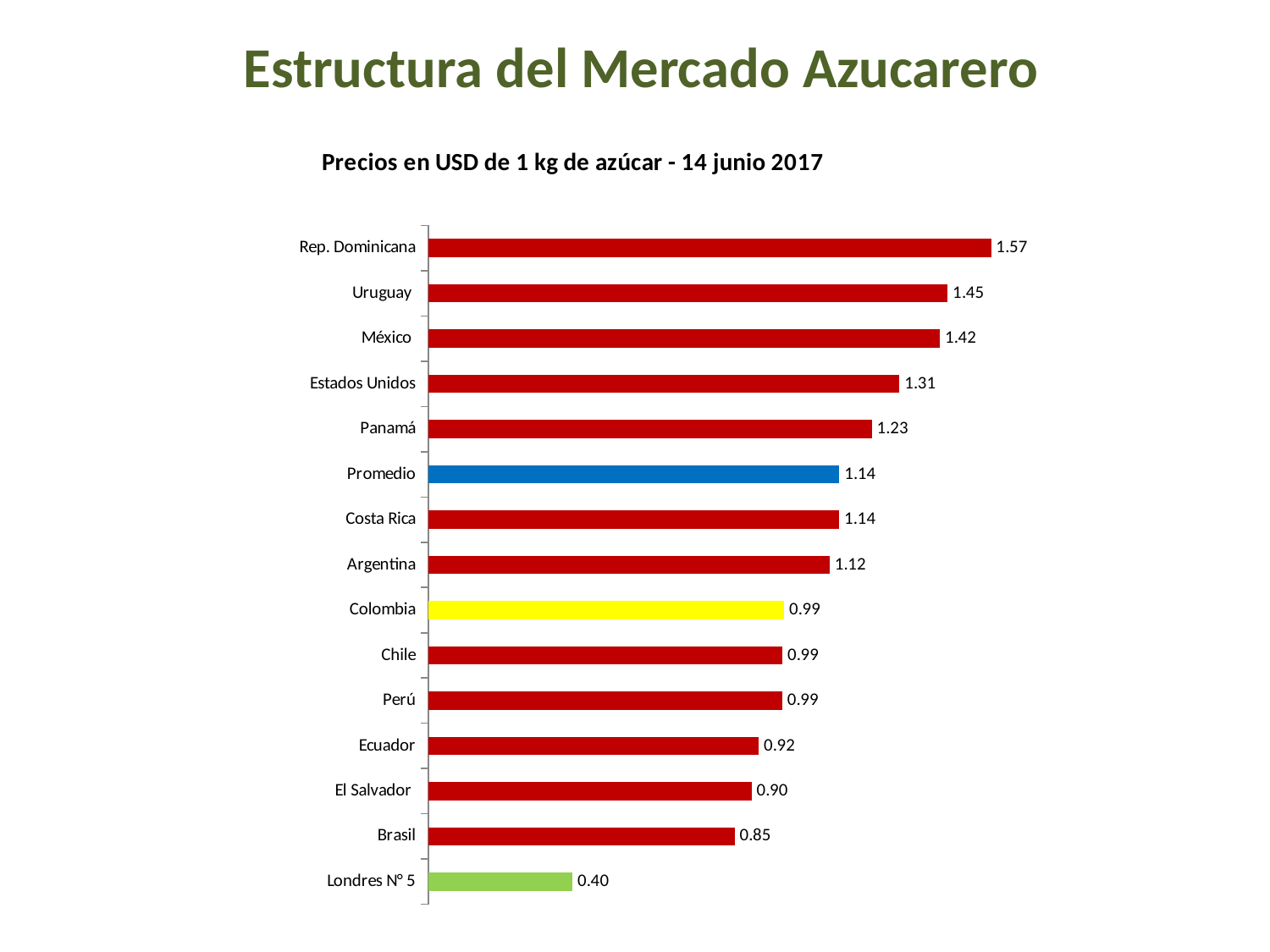
How many categories are shown in the chart? 15 Which category has the lowest value? Londres N° 5 Which category has the highest price? Rep. Dominicana Which has a higher price, Brasil or El Salvador? El Salvador What is the difference between the prices for Rep. Dominicana and Londres N° 5? 1.17 What is the difference between the prices for Uruguay and México? 0.03 Which has a higher price, Estados Unidos or Panamá? Estados Unidos What is the price for Colombia? 0.99 What is the price for Rep. Dominicana? 1.57 What is the value shown for Promedio? 1.14 What kind of chart is shown on the slide? Bar chart What is the title of the chart? Precios en USD de 1 kg de azúcar - 14 junio 2017